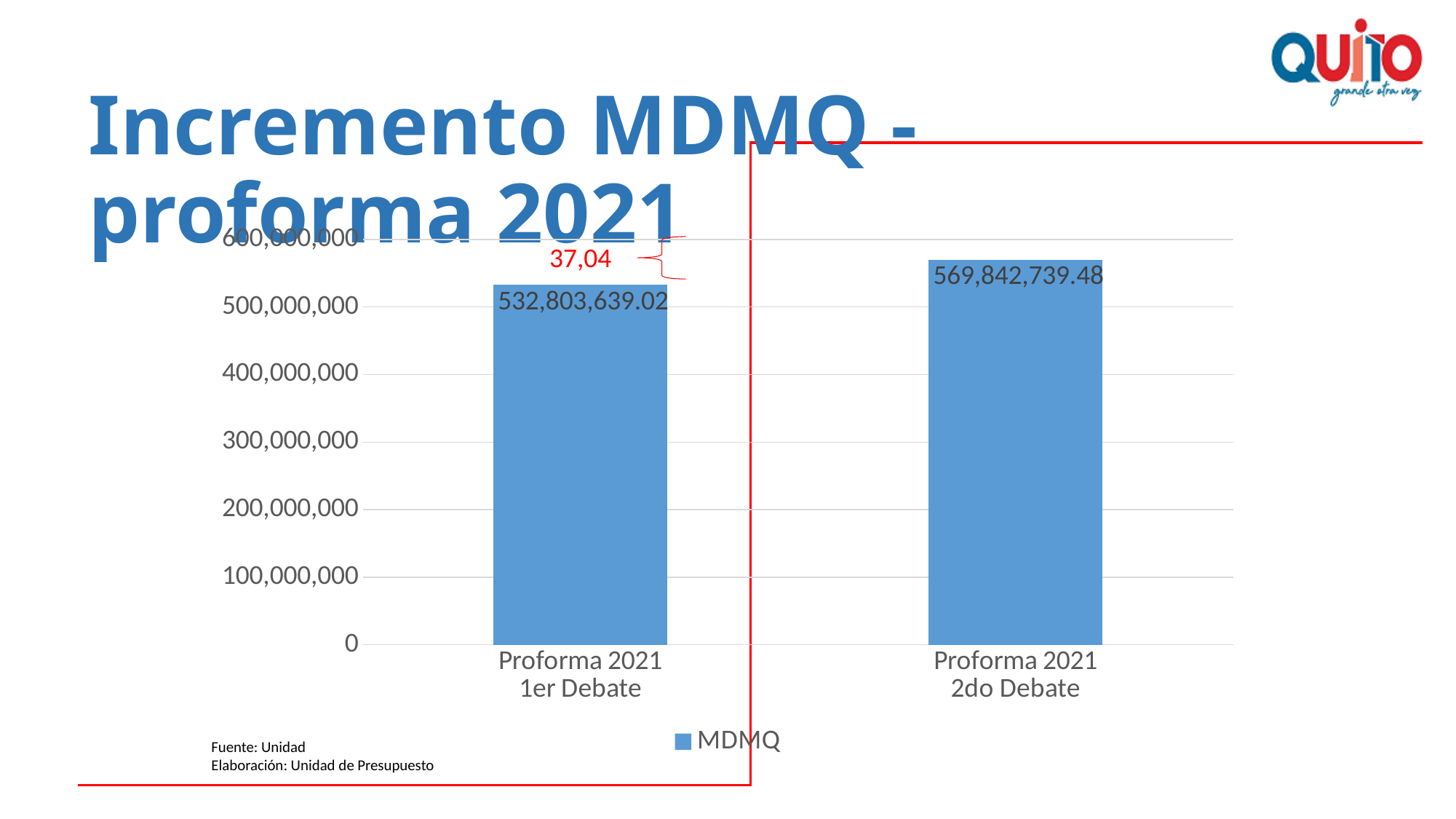
What is the value for Proforma 2021 1er Debate? 532,803,639.02 Which category has the lowest value? Proforma 2021 1er Debate How many categories are shown on the x axis? 2 Is the value for Proforma 2021 1er Debate greater or less than 500,000,000? greater What is the value for Proforma 2021 2do Debate? 569,842,739.48 What is the difference between the value for Proforma 2021 2do Debate and the value for Proforma 2021 1er Debate? 37,039,100.46 Which category has the highest value? Proforma 2021 2do Debate What kind of chart is shown on the slide? Bar chart How many series does the legend list? 1 Is the value for Proforma 2021 2do Debate greater or less than 600,000,000? less What series name is shown in the legend? MDMQ Which is larger, the value for Proforma 2021 1er Debate or the value for Proforma 2021 2do Debate? Proforma 2021 2do Debate